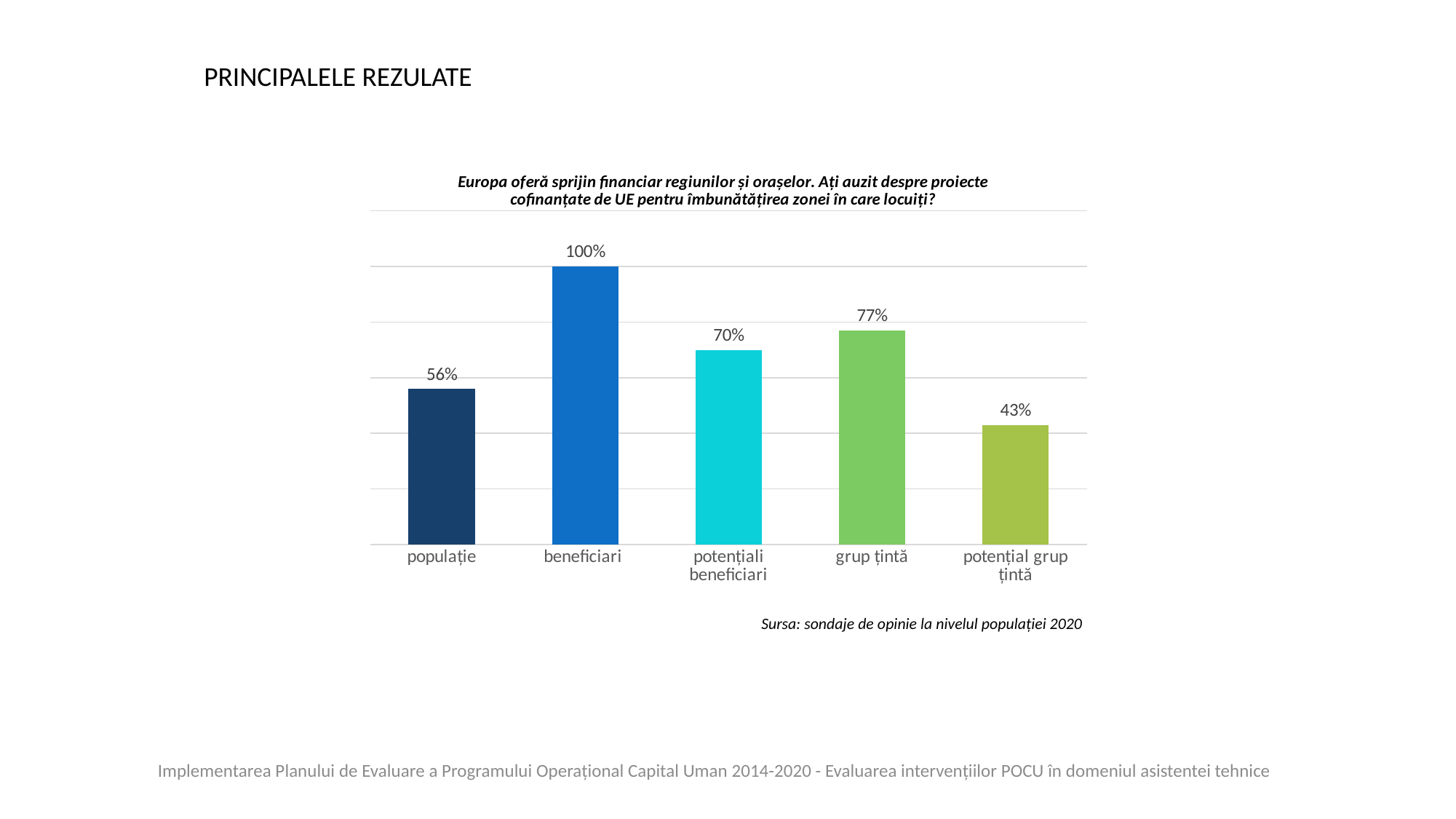
Which category has the highest value? beneficiari How many categories are shown on the chart? 5 What kind of chart is shown on the slide? bar chart What is the value for beneficiari? 100% What is the difference between the values for grup țintă and potențiali beneficiari? 7% Which is larger, the value for populație or the value for potențial grup țintă? populație What source is cited below the chart? Sursa: sondaje de opinie la nivelul populației 2020 Which category has the lowest value? potențial grup țintă What is the value for populație? 56% What is the value for potențial grup țintă? 43% What is the value for potențiali beneficiari? 70% What is the value for grup țintă? 77%